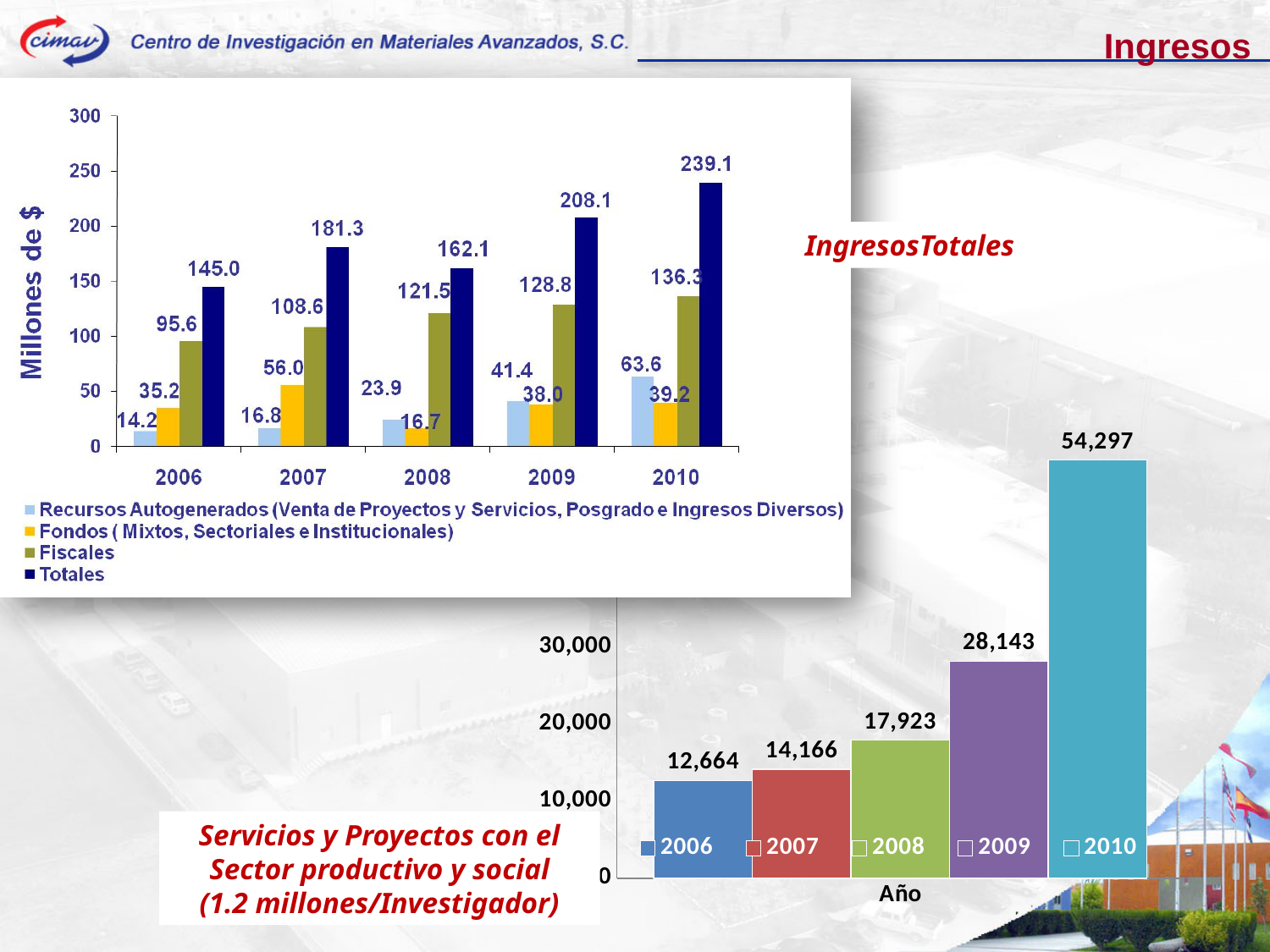
In the Ingresos Totales chart, what is the Totales value for 2010? 239.1 In the Ingresos Totales chart, do the Fiscales values rise or fall from 2006 to 2010? rise In the Ingresos Totales chart, which year has the lowest Totales value? 2006 In the Ingresos Totales chart, what is the Fondos value for 2007? 56.0 In the Servicios y Proyectos con el Sector productivo y social chart, which year has the highest value? 2010 In the Ingresos Totales chart, what is the Fiscales value for 2008? 121.5 In the Servicios y Proyectos con el Sector productivo y social chart, what is the value for 2009? 28,143 In the Servicios y Proyectos con el Sector productivo y social chart, what is the difference between the values for 2010 and 2009? 26,154 How many series does the legend of the Ingresos Totales chart list? 4 In the Ingresos Totales chart, what is the difference between the Totales values for 2010 and 2009? 31.0 In the Ingresos Totales chart, which is larger in 2008: Recursos Autogenerados or Fondos? Recursos Autogenerados What kind of chart is the Servicios y Proyectos con el Sector productivo y social chart? bar chart